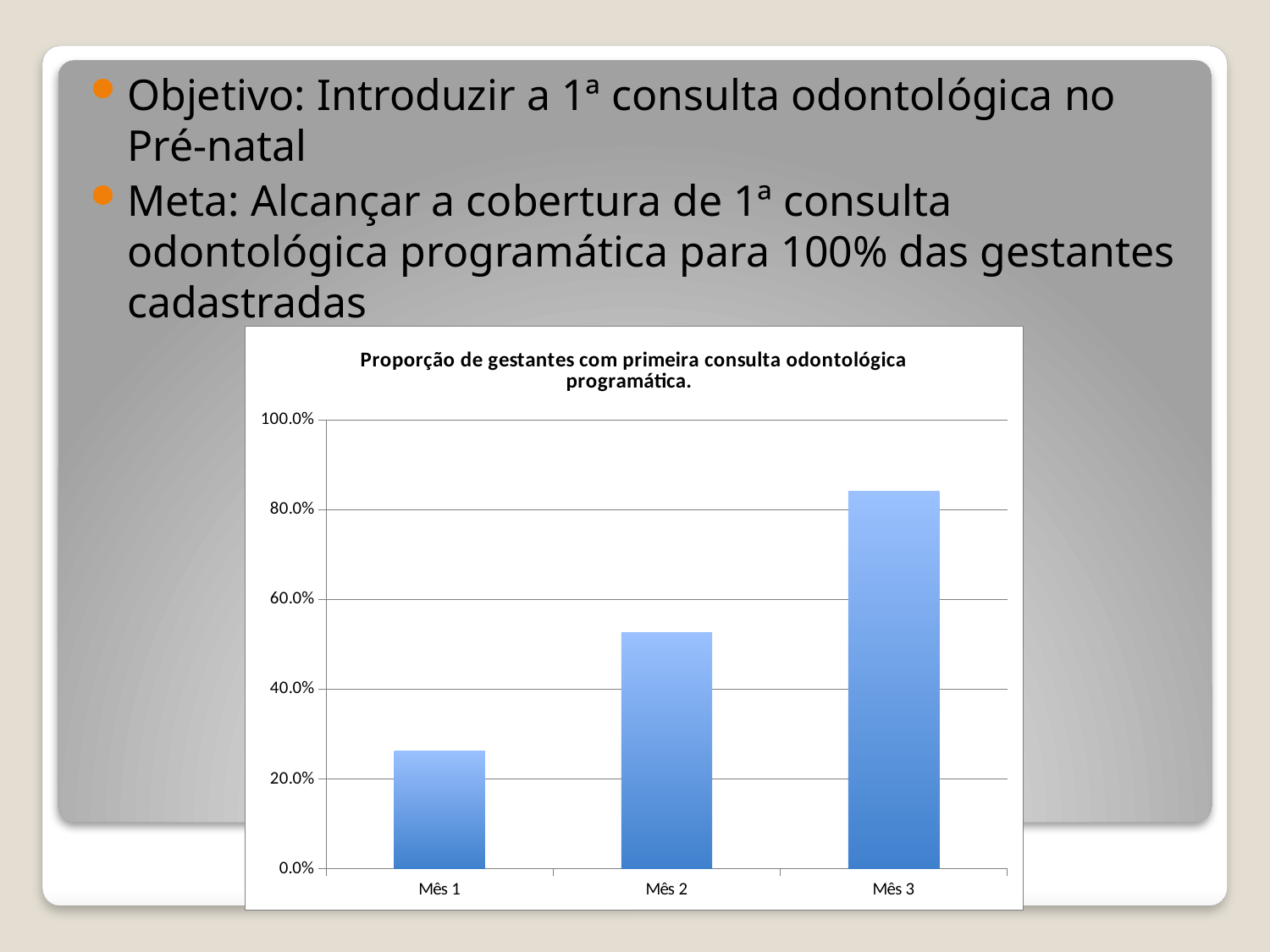
Is the value for Mês 1 greater or less than 20.0%? greater How many categories are shown on the x axis of the chart? 3 Which month has the highest proportion in the chart? Mês 3 Which month has the lowest proportion in the chart? Mês 1 Is the value for Mês 1 greater or less than 40.0%? less Do the values rise or fall from Mês 1 to Mês 3? rise What type of chart is shown on the slide? bar chart Is the value for Mês 2 greater or less than 60.0%? less Which is larger, the value for Mês 2 or the value for Mês 3? Mês 3 What is the title of the chart? Proporção de gestantes com primeira consulta odontológica programática.